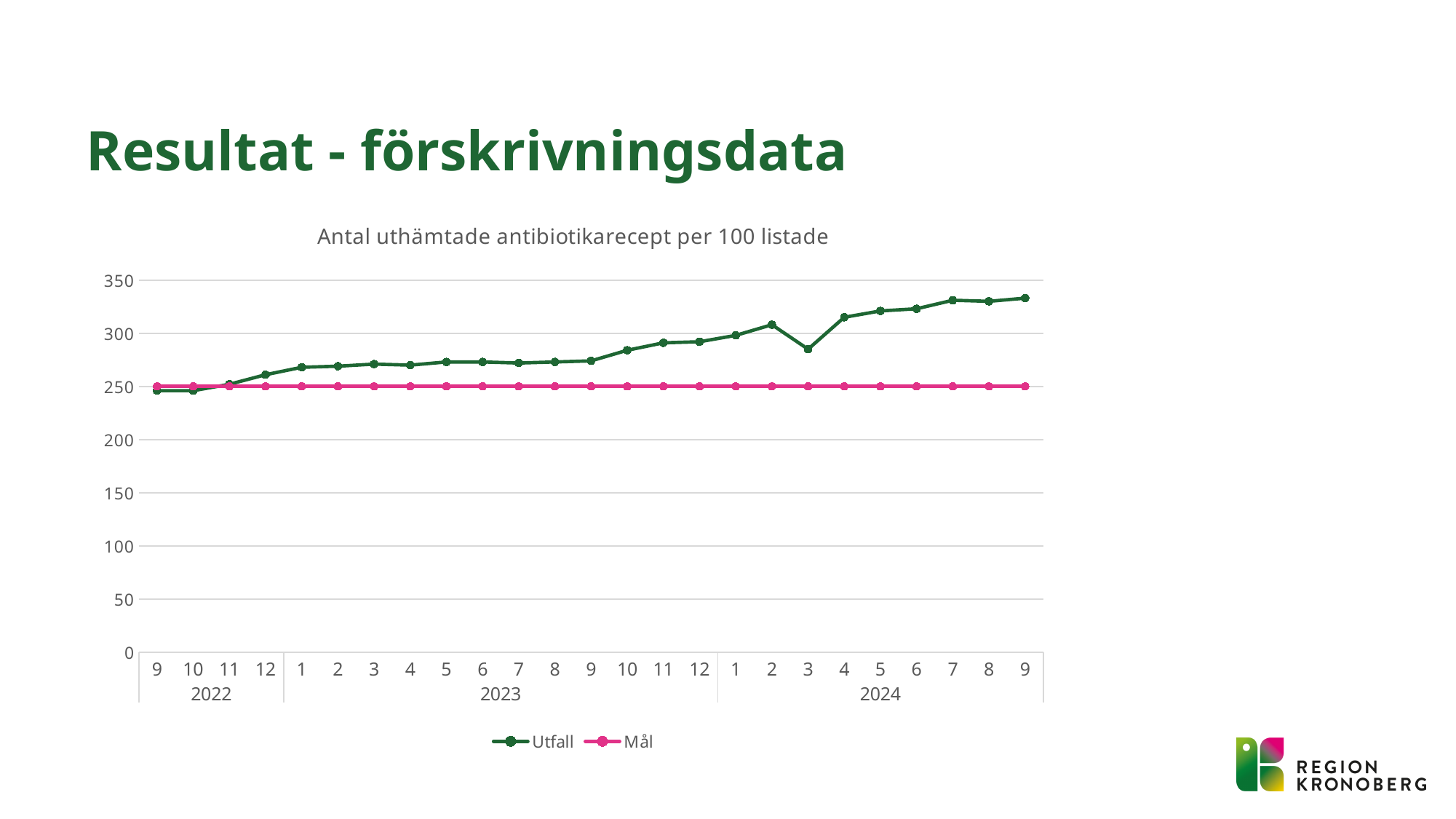
Is the Utfall value for month 3 of 2024 greater or less than 300? less What is the value of the Mål series throughout the period? 250 In month 9 of 2024, which series has the higher value, Utfall or Mål? Utfall Does the Utfall series generally rise or fall from 9 2022 to 9 2024? rise What are the names of the two series in the legend? Utfall and Mål Which series is drawn in pink? Mål Is the Utfall value for month 9 of 2024 greater or less than 300? greater What is the title of the chart? Antal uthämtade antibiotikarecept per 100 listade How many series does the legend list? 2 Is the Utfall value for month 9 of 2022 greater or less than 250? less What kind of chart is shown on the slide? line chart How many monthly data points are plotted along the x axis? 25